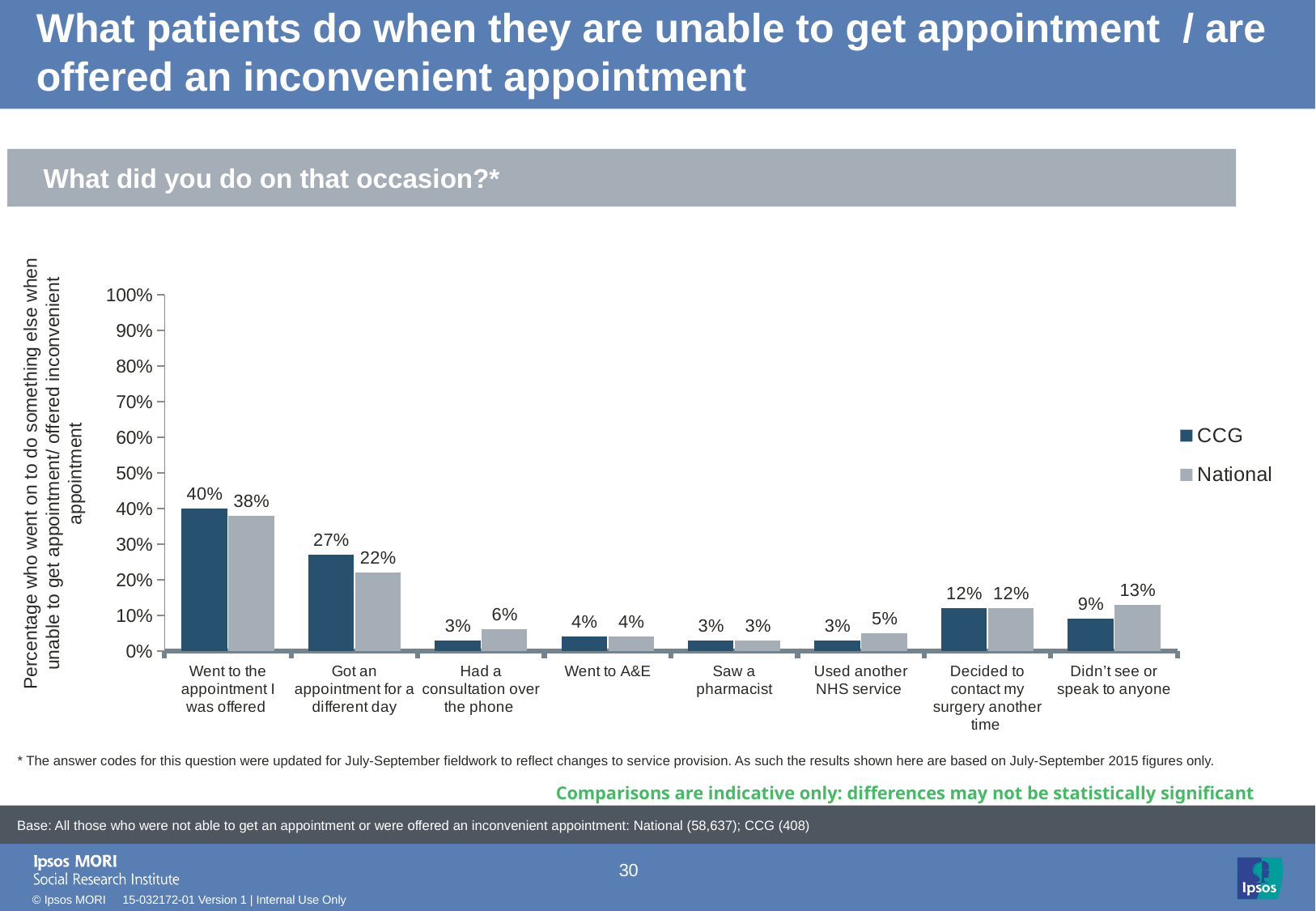
What is the National value for 'Didn't see or speak to anyone'? 13% How many series does the legend list? 2 What is the CCG value for 'Went to the appointment I was offered'? 40% Which is larger for 'Had a consultation over the phone', the CCG value or the National value? National How many categories are shown on the x axis? 8 What kind of chart is shown on the slide? Bar chart What are the two series listed in the legend? CCG and National Is the CCG value for 'Went to the appointment I was offered' greater or less than 30%? greater What is the CCG value for 'Used another NHS service'? 3% Which category has the highest CCG value? Went to the appointment I was offered What is the National value for 'Got an appointment for a different day'? 22% What is the difference between the CCG and National values for 'Got an appointment for a different day'? 5%